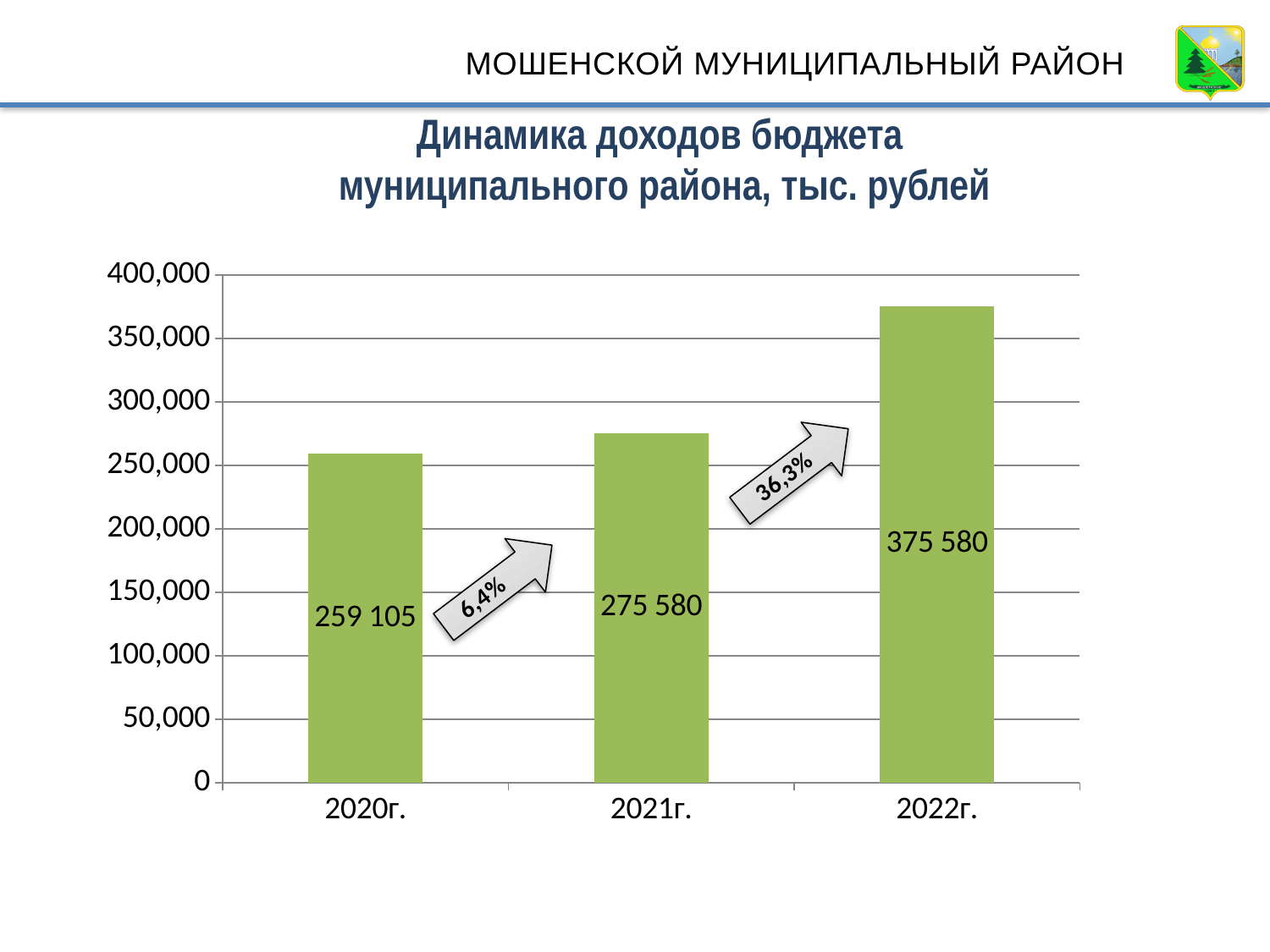
What kind of chart is shown on the slide? bar chart What is the budget revenue value shown for 2022г.? 375 580 Which year has the highest budget revenue? 2022г. Which is larger, the value for 2021г. or the value for 2020г.? 2021г. What is the budget revenue value shown for 2020г.? 259 105 What is the budget revenue value shown for 2021г.? 275 580 What percentage growth is shown on the arrow between 2021г. and 2022г.? 36,3% Which year has the lowest budget revenue? 2020г. What is the difference between the values for 2022г. and 2021г.? 100 000 Is the value for 2022г. greater or less than 350,000? greater What is the difference between the values for 2021г. and 2020г.? 16 475 How many years are shown on the x axis? 3